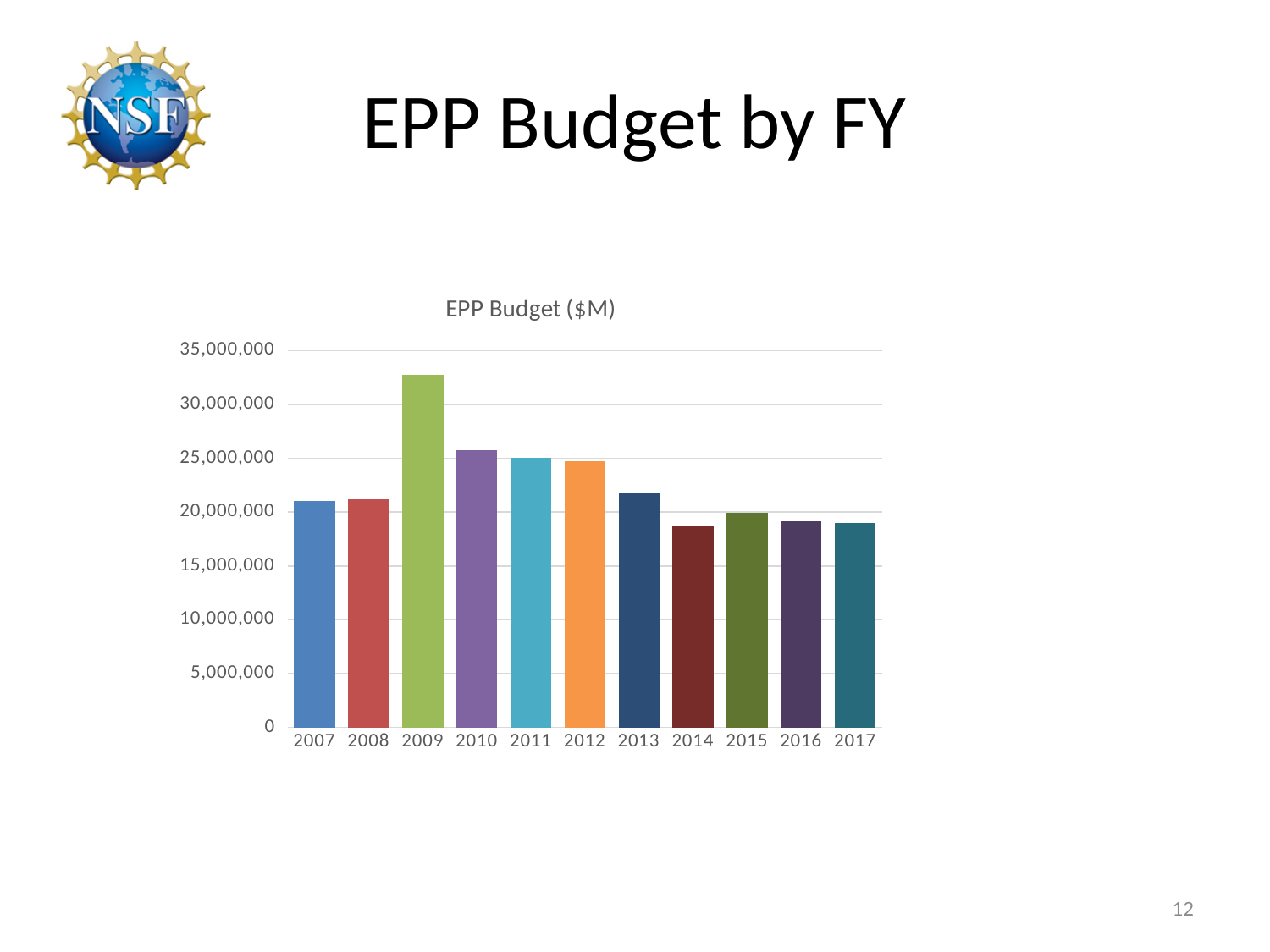
Is the value for 2014 greater or less than 20,000,000? less Do the values rise or fall from 2009 to 2014? fall What kind of chart is shown on the slide? bar chart Is the value for 2009 greater or less than 30,000,000? greater Which fiscal year has the highest EPP budget? 2009 Which is larger, the value for 2009 or the value for 2010? 2009 Which is larger, the value for 2010 or the value for 2012? 2010 Is the value for 2007 greater or less than 25,000,000? less Which is larger, the value for 2013 or the value for 2014? 2013 What is the title of the chart? EPP Budget ($M) How many fiscal years are plotted on the x axis? 11